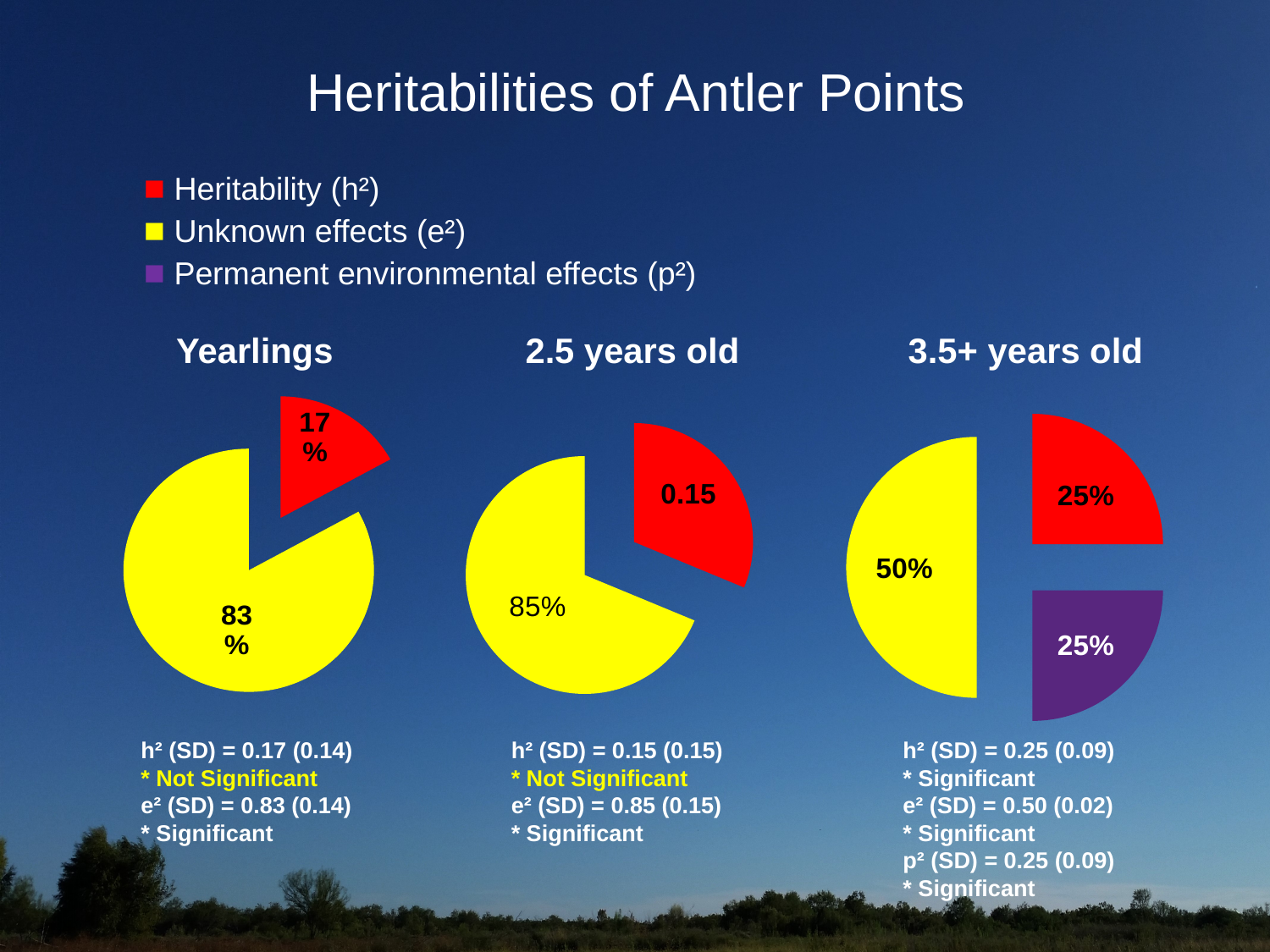
How many slices does the 3.5+ years old pie chart have? 3 In the 3.5+ years old pie chart, what share is labelled on the yellow Unknown effects (e²) slice? 50% In the 2.5 years old pie chart, what share is labelled on the yellow Unknown effects (e²) slice? 85% What type of chart is used for the Yearlings, 2.5 years old and 3.5+ years old groups? Pie chart In the Yearlings pie chart, what share is labelled on the yellow Unknown effects (e²) slice? 83% In the 3.5+ years old pie chart, which slice is the largest? Unknown effects (e²) How many entries does the legend at the top of the slide list? 3 In the Yearlings pie chart, which slice is the largest? Unknown effects (e²) In the Yearlings pie chart, what share is labelled on the red Heritability (h²) slice? 17% In the 3.5+ years old pie chart, what share is labelled on the purple Permanent environmental effects (p²) slice? 25% In the Yearlings pie chart, what is the difference between the Unknown effects (e²) share and the Heritability (h²) share? 66% In the 2.5 years old pie chart, what value is labelled on the red Heritability (h²) slice? 0.15